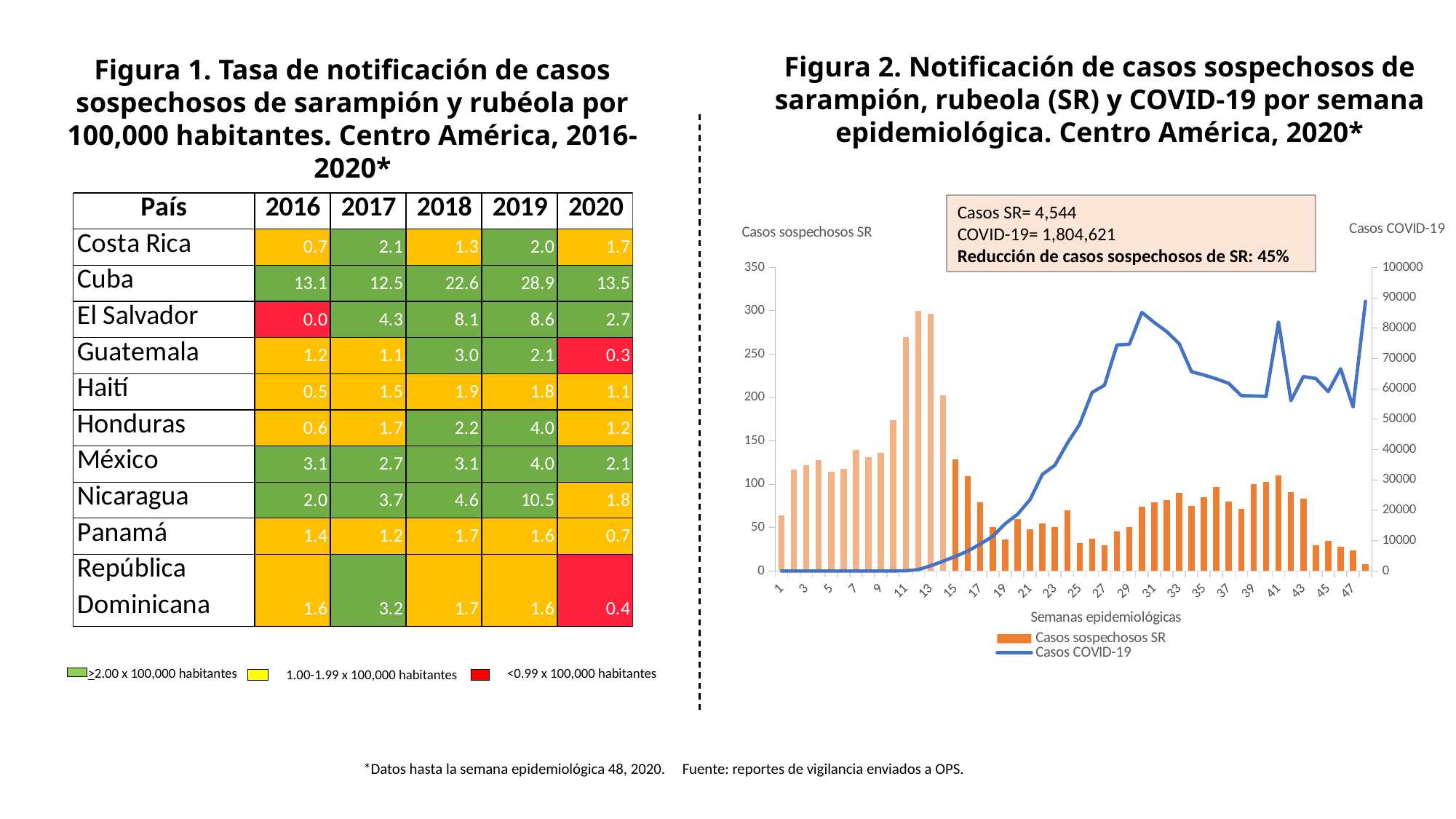
In Figura 2, is the value of Casos COVID-19 for week 48 greater or less than 80000? greater In Figura 2, is the value of Casos sospechosos SR for week 12 greater or less than 250? greater In Figura 2, do the Casos COVID-19 values rise or fall between week 15 and week 30? Rise In Figura 2, what kind of chart is used to show the suspected SR cases and the COVID-19 cases? A combined bar and line chart (bars for SR cases, line for COVID-19 cases) In Figura 2, which series is drawn as a line? Casos COVID-19 In Figura 2, is the value of Casos COVID-19 for week 10 greater or less than 10000? less In Figura 2, do the Casos sospechosos SR values rise or fall between week 13 and week 19? Fall In Figura 2, which week has the larger number of Casos sospechosos SR, week 12 or week 41? Week 12 In Figura 2, how many series does the legend list? 2 In Figura 2, what is the label of the x axis? Semanas epidemiológicas